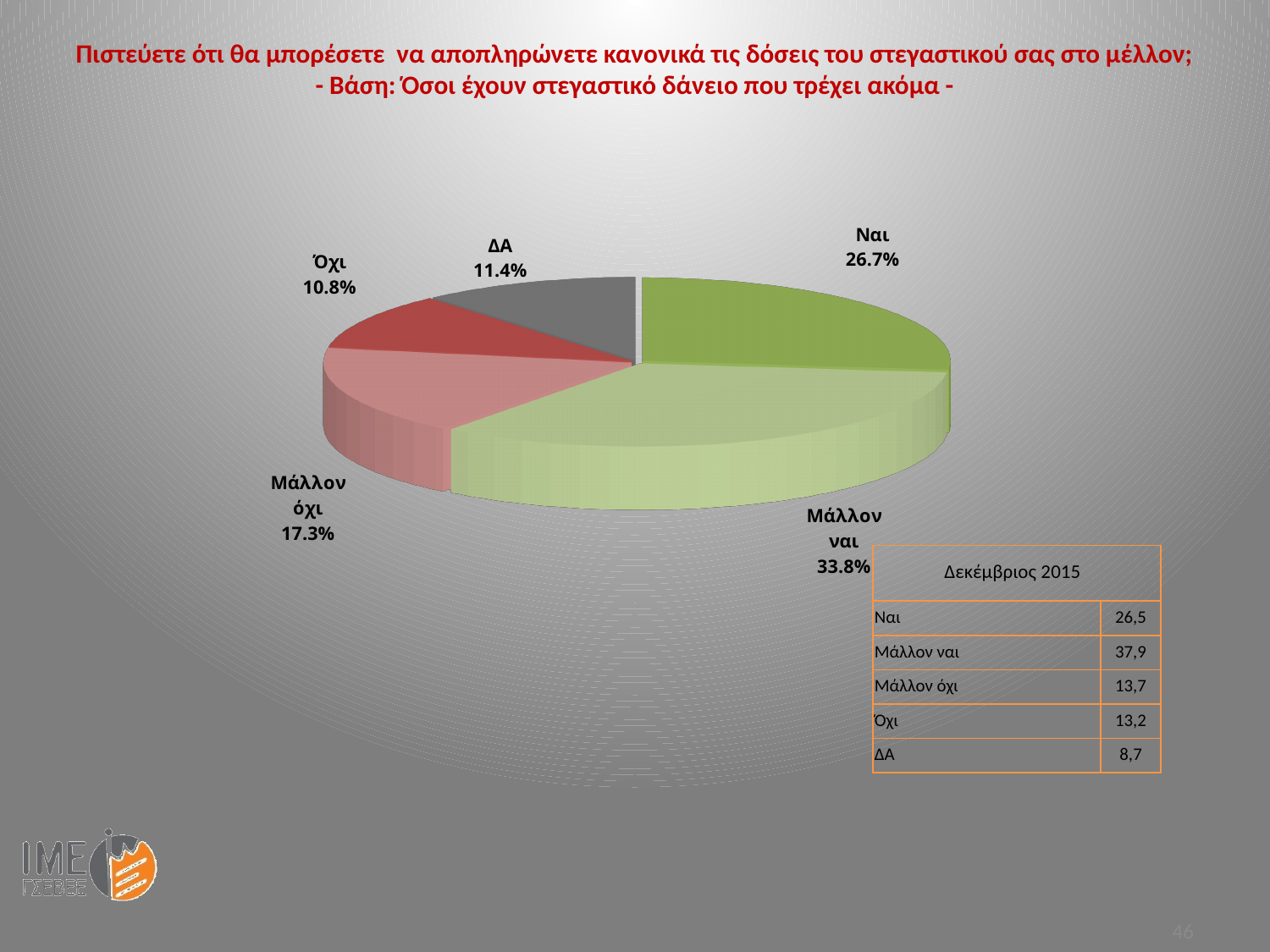
What is the difference between the "Μάλλον ναι" and "Ναι" slices? 7.1% Which is larger, the "Μάλλον όχι" slice or the "ΔΑ" slice? Μάλλον όχι How many slices does the pie chart have? 5 What kind of chart is shown on the slide? pie chart What is the value for the "Όχι" slice? 10.8% Which slice of the pie chart is the smallest? Όχι What is the value for the "Μάλλον ναι" slice? 33.8% Which slice of the pie chart is the largest? Μάλλον ναι What is the value for the "Μάλλον όχι" slice? 17.3% What is the value for the "ΔΑ" slice? 11.4% What share of the pie does the "Ναι" slice represent? 26.7% What is the value for the "Ναι" slice? 26.7%